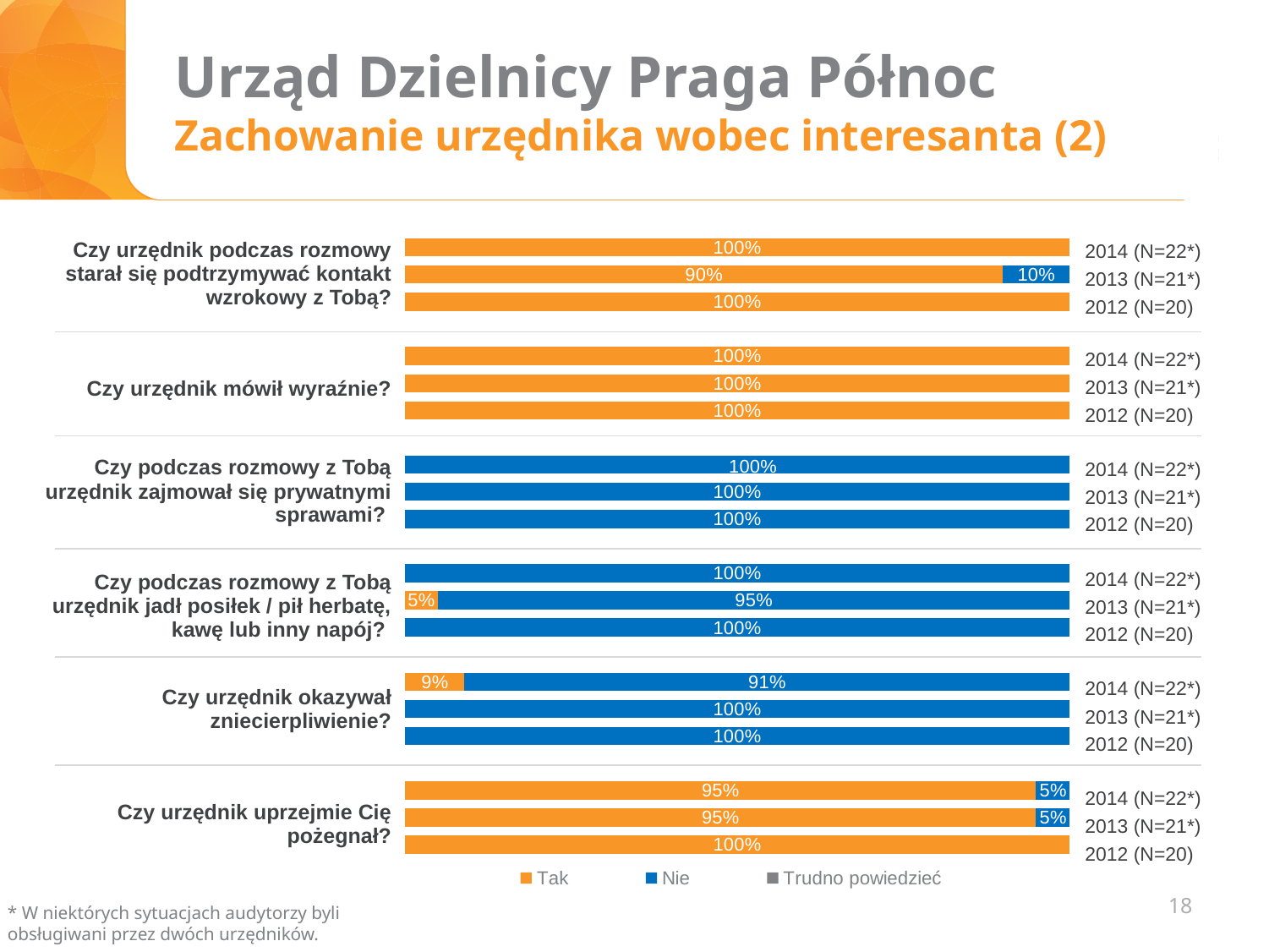
What is the 'Tak' value for 'Czy urzędnik mówił wyraźnie?' in 2012 (N=20)? 100% What is the 'Nie' value for 'Czy urzędnik podczas rozmowy starał się podtrzymywać kontakt wzrokowy z Tobą?' in 2013 (N=21*)? 10% What is the 'Tak' value for 'Czy urzędnik okazywał zniecierpliwienie?' in 2014 (N=22*)? 9% What is the 'Tak' value for 'Czy urzędnik podczas rozmowy starał się podtrzymywać kontakt wzrokowy z Tobą?' in 2013 (N=21*)? 90% For 'Czy urzędnik okazywał zniecierpliwienie?' in 2014 (N=22*), which is larger: 'Tak' or 'Nie'? Nie Which colour represents 'Tak' in the legend? Orange What is the 'Nie' value for 'Czy podczas rozmowy z Tobą urzędnik jadł posiłek / pił herbatę, kawę lub inny napój?' in 2013 (N=21*)? 95% What is the difference between the 'Tak' and 'Nie' values for 'Czy urzędnik podczas rozmowy starał się podtrzymywać kontakt wzrokowy z Tobą?' in 2013 (N=21*)? 80 percentage points What kind of chart is shown on the slide? Stacked bar chart How many questions (categories) are shown in the chart? 6 How many series does the legend list? 3 What is the 'Nie' value for 'Czy urzędnik uprzejmie Cię pożegnał?' in 2014 (N=22*)? 5%